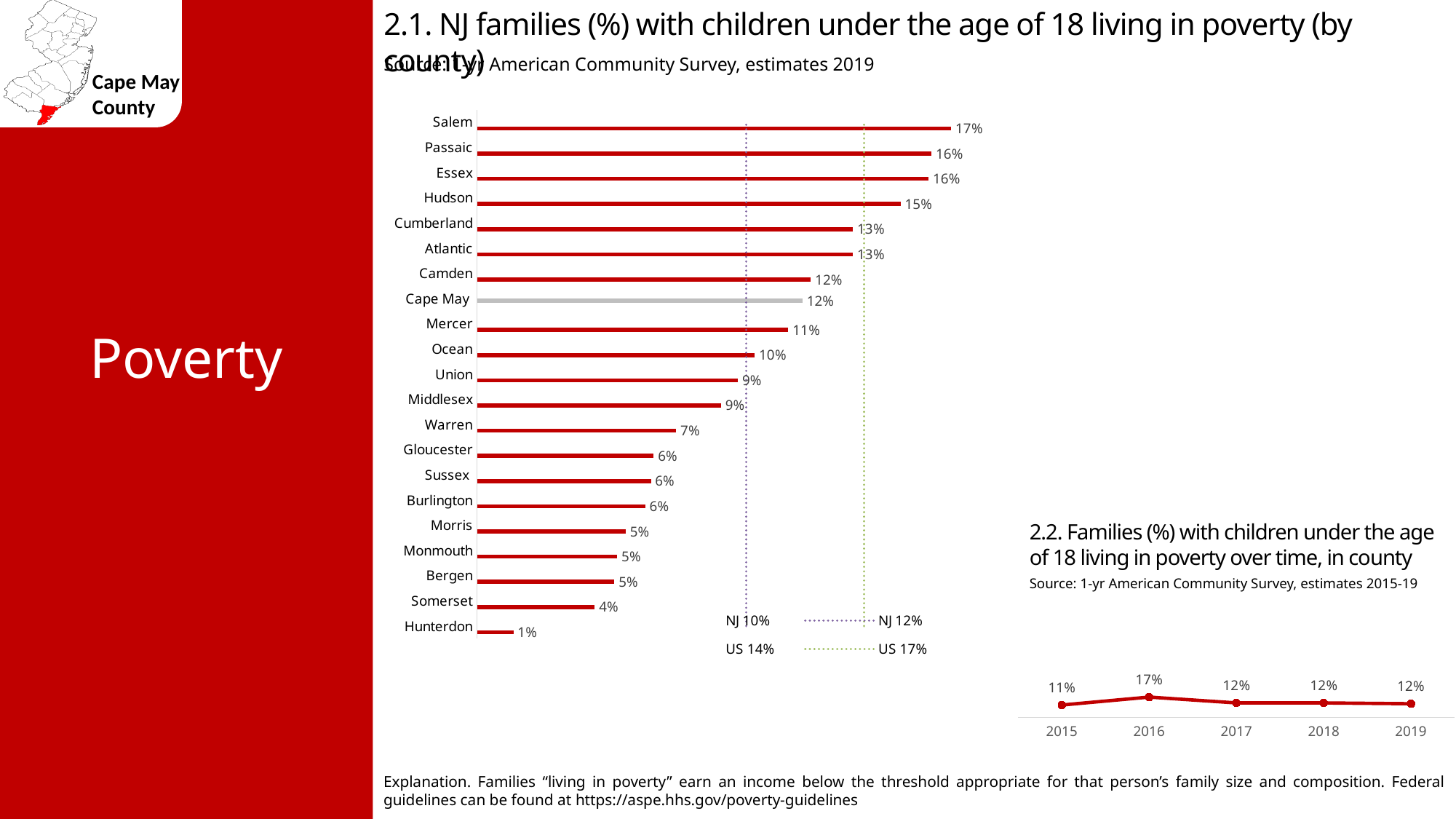
In chart 2.1 (by county), which is larger, the value for Mercer or the value for Warren? Mercer In chart 2.1 (by county), how many counties are plotted? 21 In chart 2.2 (poverty over time, in county), which year has the highest value? 2016 In chart 2.1 (NJ families with children under 18 living in poverty by county), what is the value for Cape May? 12% In chart 2.1 (by county), what is the value for Hudson? 15% In chart 2.1 (by county), what is the difference between Salem and Hunterdon? 16 percentage points In chart 2.2 (poverty over time, in county), how many years are plotted? 5 In chart 2.1 (by county), which county has the highest percentage of families with children living in poverty? Salem In chart 2.2 (poverty over time, in county), what is the value for 2016? 17% What kind of chart is chart 2.1 (by county)? Bar chart In chart 2.1 (by county), which county has the lowest percentage? Hunterdon